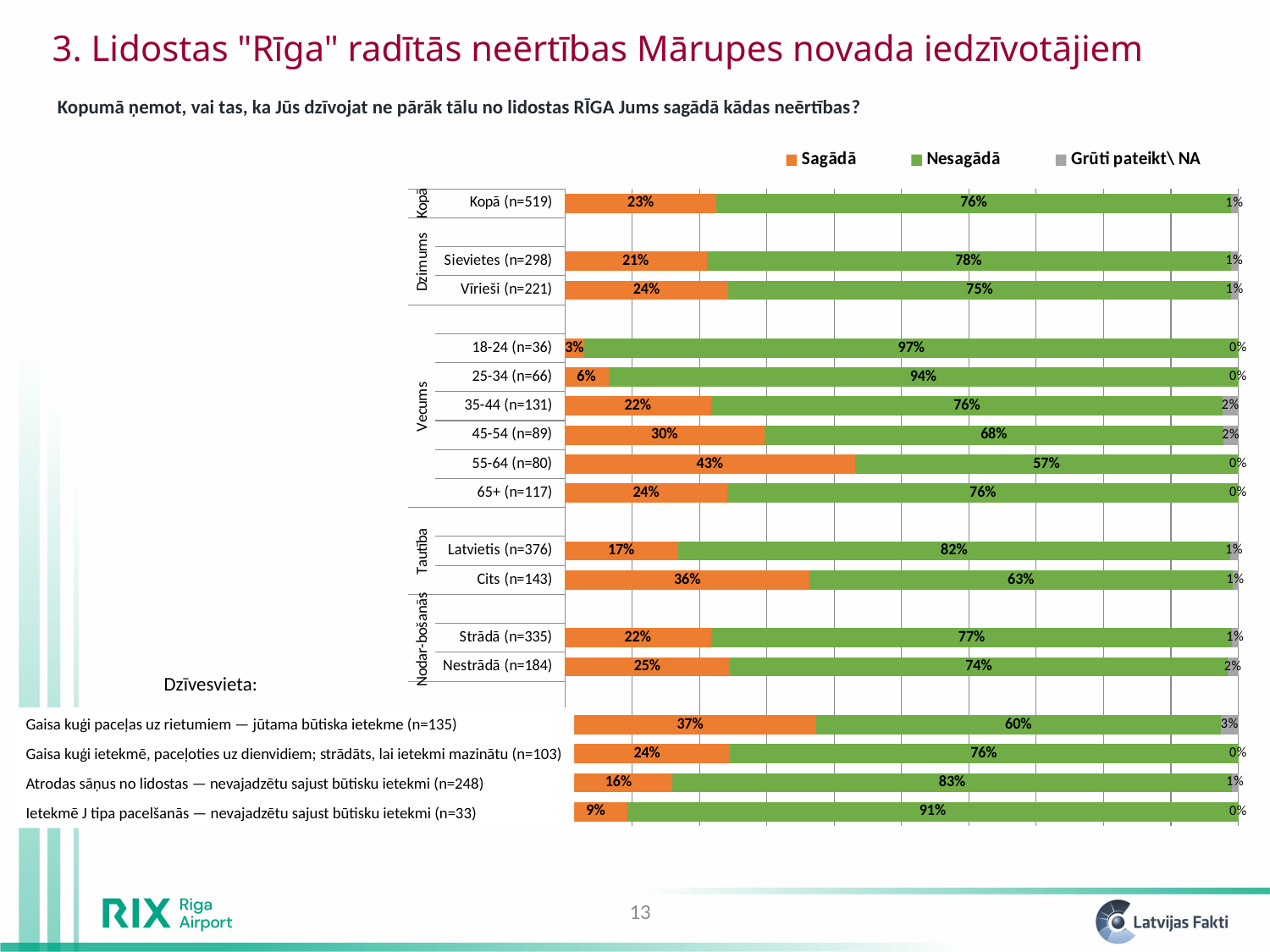
Which age group has the highest Sagādā value? 55-64 (n=80) What is the Sagādā value for Kopā (n=519)? 23% Which has a larger Nesagādā value, Strādā (n=335) or Nestrādā (n=184)? Strādā (n=335) What is the difference between the Sagādā values for Cits (n=143) and Latvietis (n=376)? 19% Which age group has the lowest Sagādā value? 18-24 (n=36) Which colour represents the Sagādā series in the chart? Orange What is the Nesagādā value for the row 'Ietekmē J tipa pacelšanās — nevajadzētu sajust būtisku ietekmi (n=33)'? 91% How many series does the legend list? 3 What is the Nesagādā value for Sievietes (n=298)? 78% What kind of chart is shown on the slide? Stacked bar chart What is the Grūti pateikt\ NA value for 45-54 (n=89)? 2% What is the Sagādā value for 55-64 (n=80)? 43%